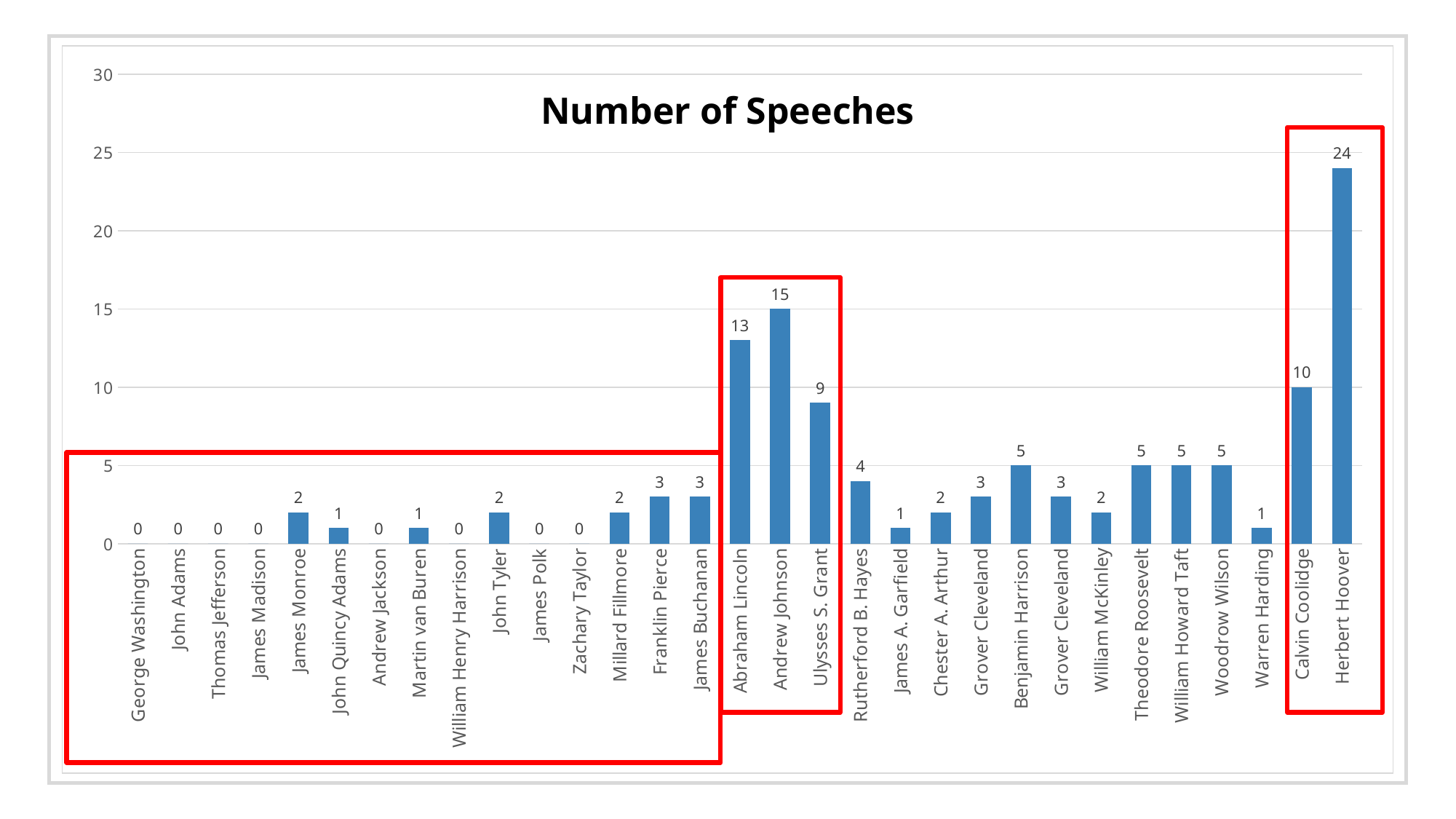
What kind of chart is shown on the slide? Bar chart Which president has the highest number of speeches? Herbert Hoover What is the difference in number of speeches between Herbert Hoover and Calvin Coolidge? 14 How many presidents are shown on the x axis of the chart? 31 What is the number of speeches for Herbert Hoover? 24 Who has more speeches, Andrew Johnson or Abraham Lincoln? Andrew Johnson What is the number of speeches for Abraham Lincoln? 13 Who has more speeches, Benjamin Harrison or Grover Cleveland? Benjamin Harrison What is the number of speeches for Rutherford B. Hayes? 4 What is the title of the chart? Number of Speeches What is the difference in number of speeches between Andrew Johnson and Ulysses S. Grant? 6 What is the number of speeches for Calvin Coolidge? 10